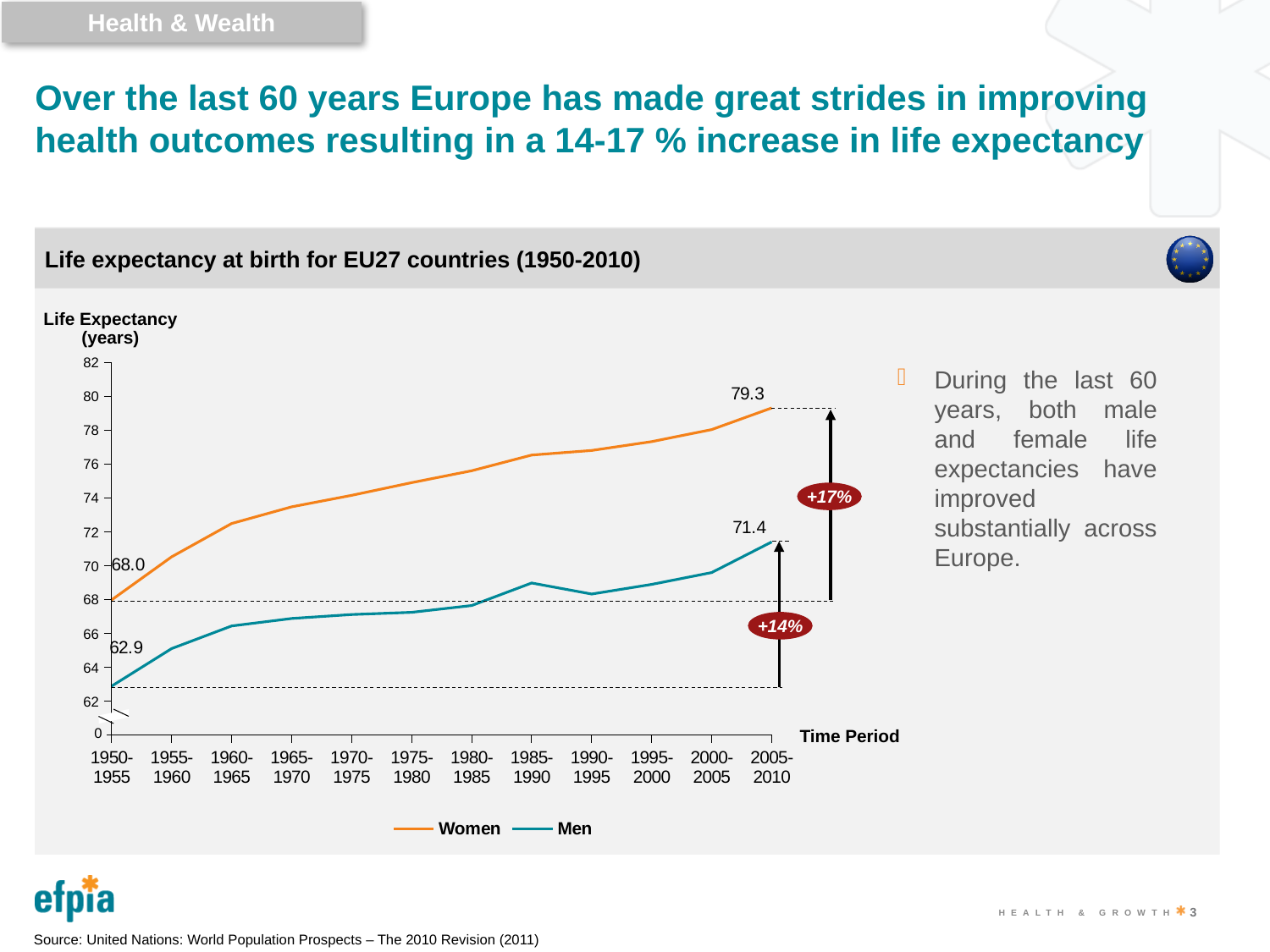
Which series has the higher life expectancy in the 2005-2010 period, Women or Men? Women What is the difference between the Women and Men life expectancy values in the 2005-2010 period? 7.9 How many series does the legend list? 2 What kind of chart is shown on the slide? Line chart What is the life expectancy for Women in the 1950-1955 period? 68.0 By how much did the Women life expectancy value increase from 1950-1955 to 2005-2010? 11.3 How many time periods are shown on the x axis? 12 Is the value for Men in the 1985-1990 period greater or less than 70? less What is the life expectancy for Women in the 2005-2010 period? 79.3 What is the life expectancy for Men in the 2005-2010 period? 71.4 Is the value for Women in the 1980-1985 period greater or less than 74? greater What is the life expectancy for Men in the 1950-1955 period? 62.9